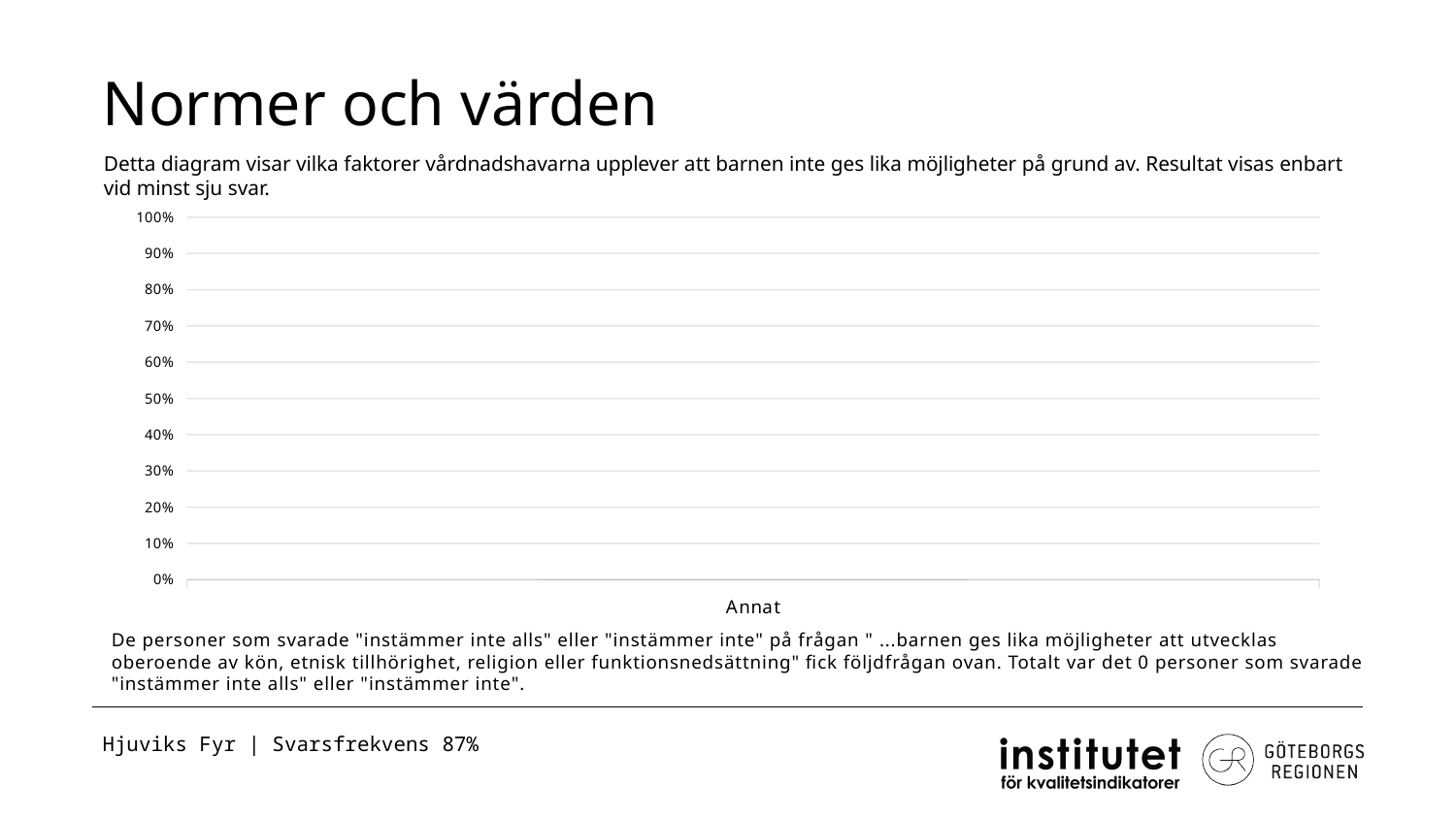
Are any bars or data points plotted in the chart? No How many tick labels are shown on the chart's y axis? 11 What is the highest value shown on the chart's y axis? 100% What is the category label shown on the x axis of the chart? Annat What is the lowest value shown on the chart's y axis? 0% How many category labels are shown on the x axis of the chart? 1